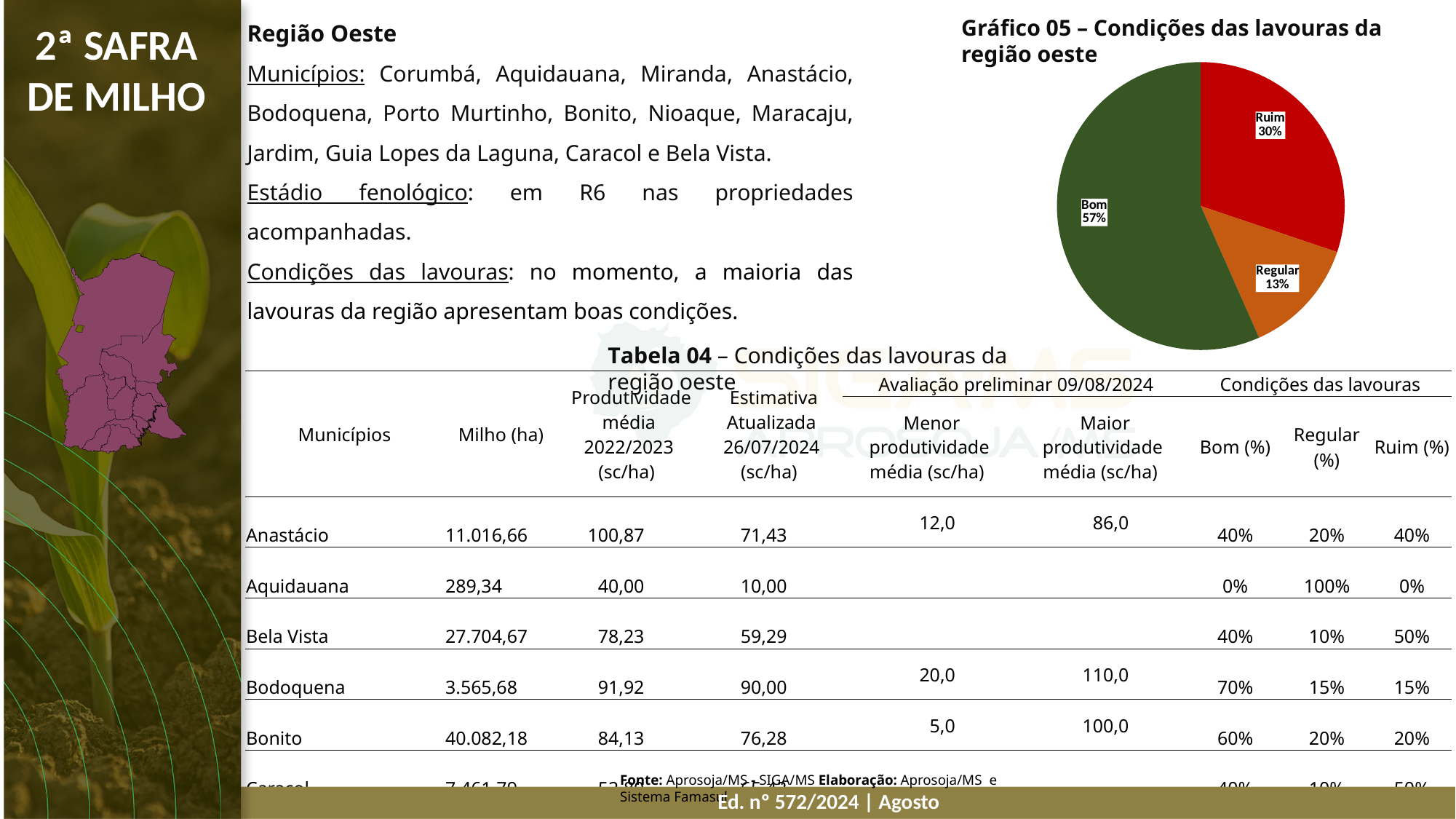
How many slices does the pie chart have? 3 Which category has the largest slice in the pie chart? Bom What is the difference in percentage points between the "Bom" and "Ruim" slices? 27 What share of the pie chart is labelled "Bom"? 57% What is the title of the chart on the slide? Gráfico 05 – Condições das lavouras da região oeste What is the difference in percentage points between the "Ruim" and "Regular" slices? 17 What percentage does the "Ruim" slice show in the pie chart? 30% Which category has the smallest slice in the pie chart? Regular What colour is the "Bom" slice in the pie chart? Dark green What value is shown for "Regular" in the pie chart? 13% Which slice is larger in the pie chart, "Ruim" or "Regular"? Ruim What type of chart is Gráfico 05? Pie chart